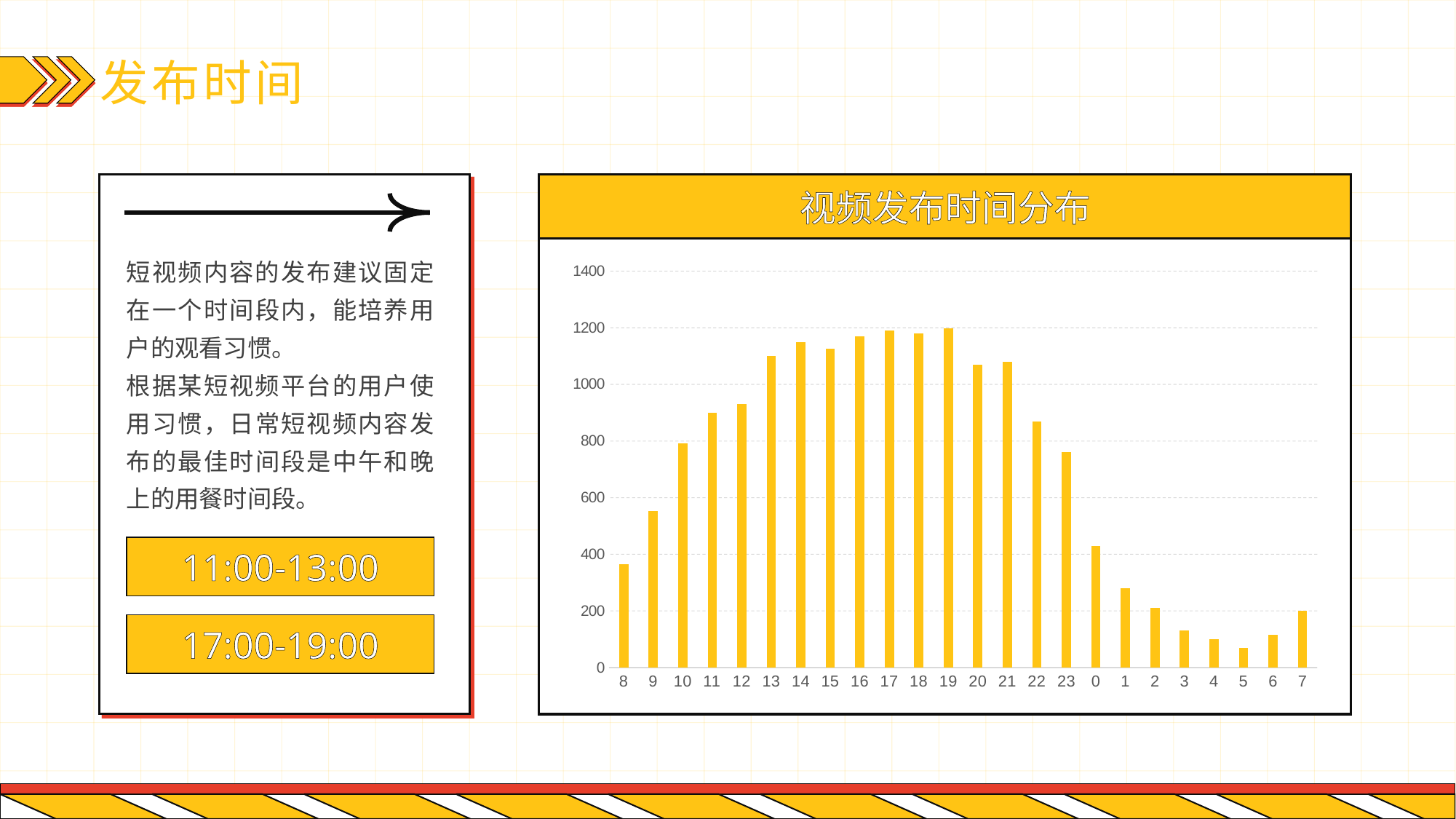
Is the value for hour 22 greater or less than 800? greater Do the values rise or fall from hour 8 to hour 13 along the x axis? rise Which has a higher value, hour 12 or hour 23? 12 What is the title of the chart? 视频发布时间分布 Is the value for hour 23 greater or less than 800? less How many hour categories are shown on the x axis of the chart? 24 Which hour has the lowest bar in the chart? 5 What kind of chart is shown on the slide? bar chart Is the value for hour 1 greater or less than 400? less Which has a higher value, hour 9 or hour 1? 9